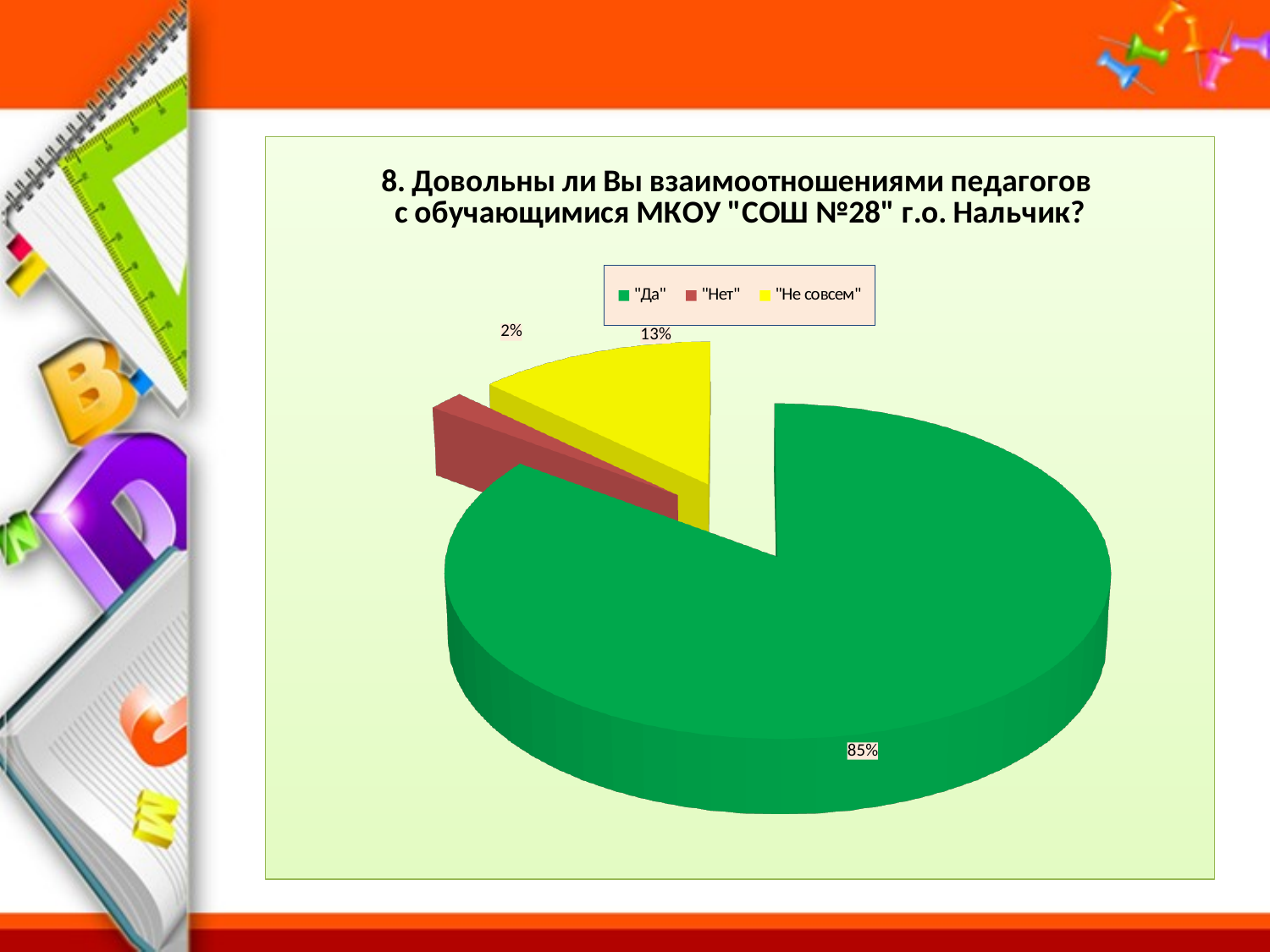
Which answer has the largest share of the pie? "Да" Which answer has the smallest share of the pie? "Нет" How many slices does the pie chart have? 3 What colour is the slice for "Не совсем"? Yellow What kind of chart is shown on the slide? Pie chart What is the difference in percentage points between the "Не совсем" and "Нет" slices? 11 What percentage of respondents answered "Да"? 85% What percentage of respondents answered "Не совсем"? 13% What is the difference in percentage points between the "Да" and "Не совсем" slices? 72 What percentage of respondents answered "Нет"? 2% How many entries does the legend list? 3 Which is larger, the share for "Нет" or the share for "Не совсем"? "Не совсем"